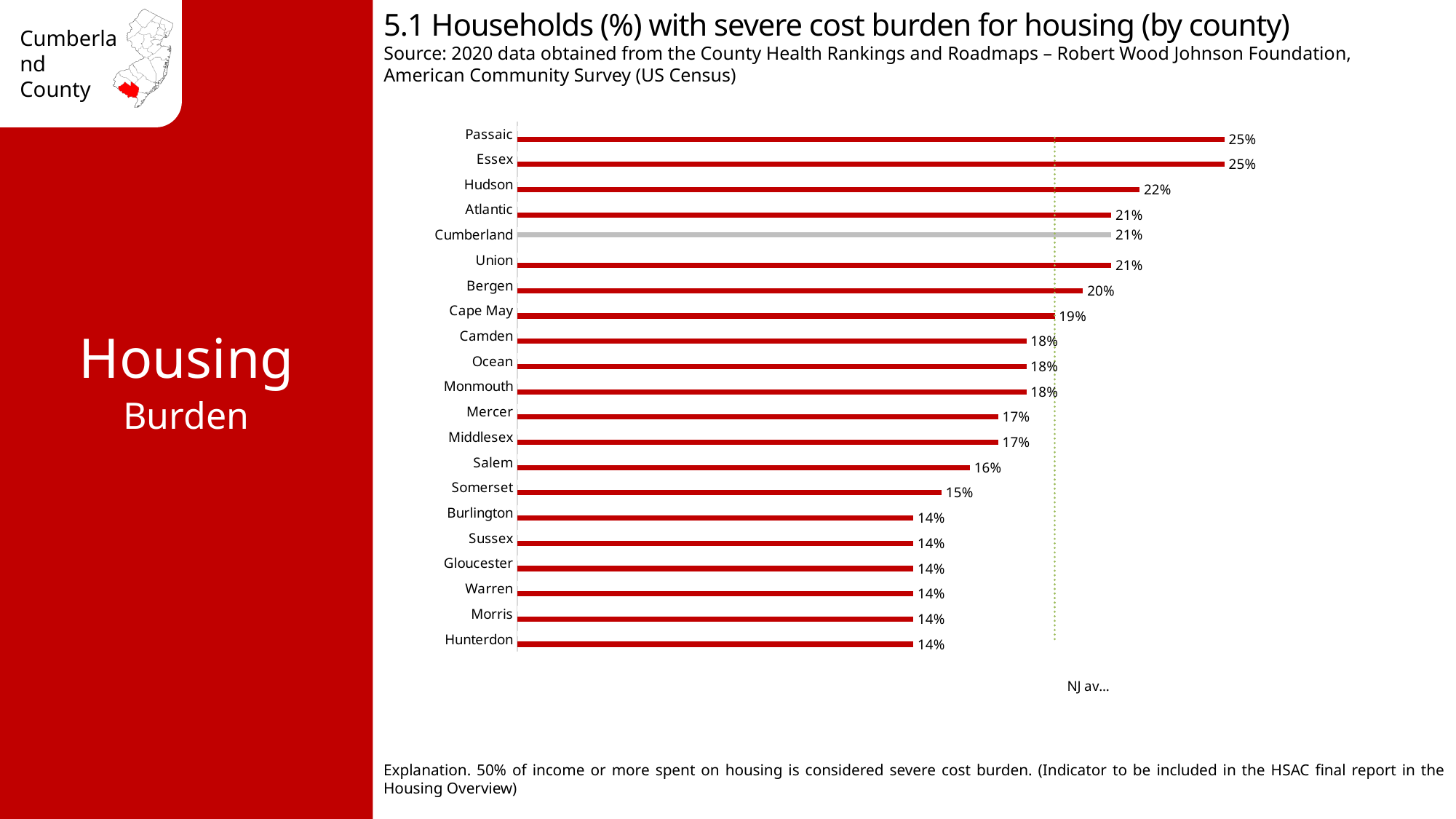
Which has a higher value, Bergen or Salem? Bergen What is the lowest percentage shown on the chart? 14% What percentage of households in Cumberland County have a severe housing cost burden? 21% Which county's bar is drawn in gray instead of red? Cumberland What is the difference in percentage points between Hudson and Hunterdon? 8 What is the highest percentage shown on the chart? 25% What kind of chart is shown on the slide? Bar chart What is the difference in percentage points between Passaic and Cumberland? 4 How many counties are shown on the chart? 21 What is the value shown for Cape May? 19% What does the vertical dotted line on the chart represent? NJ average What is the value shown for Somerset? 15%